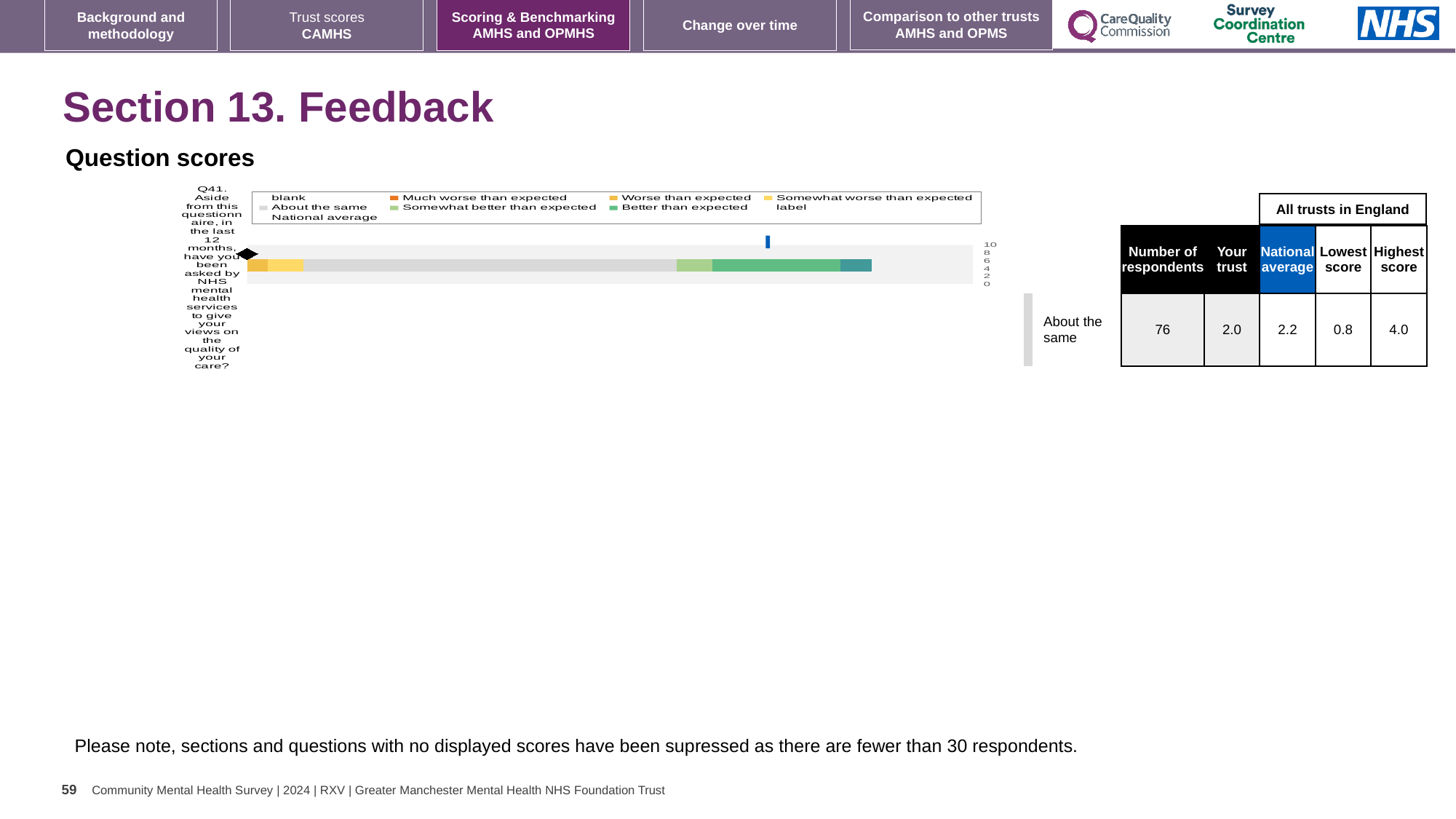
How many questions (categories) are plotted in the chart? 1 In the table next to the chart, what is the 'Your trust' score for Q41? 2.0 Is the 'Your trust' score for Q41 larger or smaller than the national average? smaller In the table next to the chart, what is the lowest score among all trusts in England for Q41? 0.8 Which question number is plotted in the chart? Q41 What is the difference between the highest score and the lowest score for Q41 in the table? 3.2 How many entries does the chart legend list? 9 In the table next to the chart, what is the number of respondents for Q41? 76 What kind of chart is shown on the slide? bar chart In the table next to the chart, what is the national average score for Q41? 2.2 What benchmark category is shown beside the chart for Q41? About the same In the table next to the chart, what is the highest score among all trusts in England for Q41? 4.0